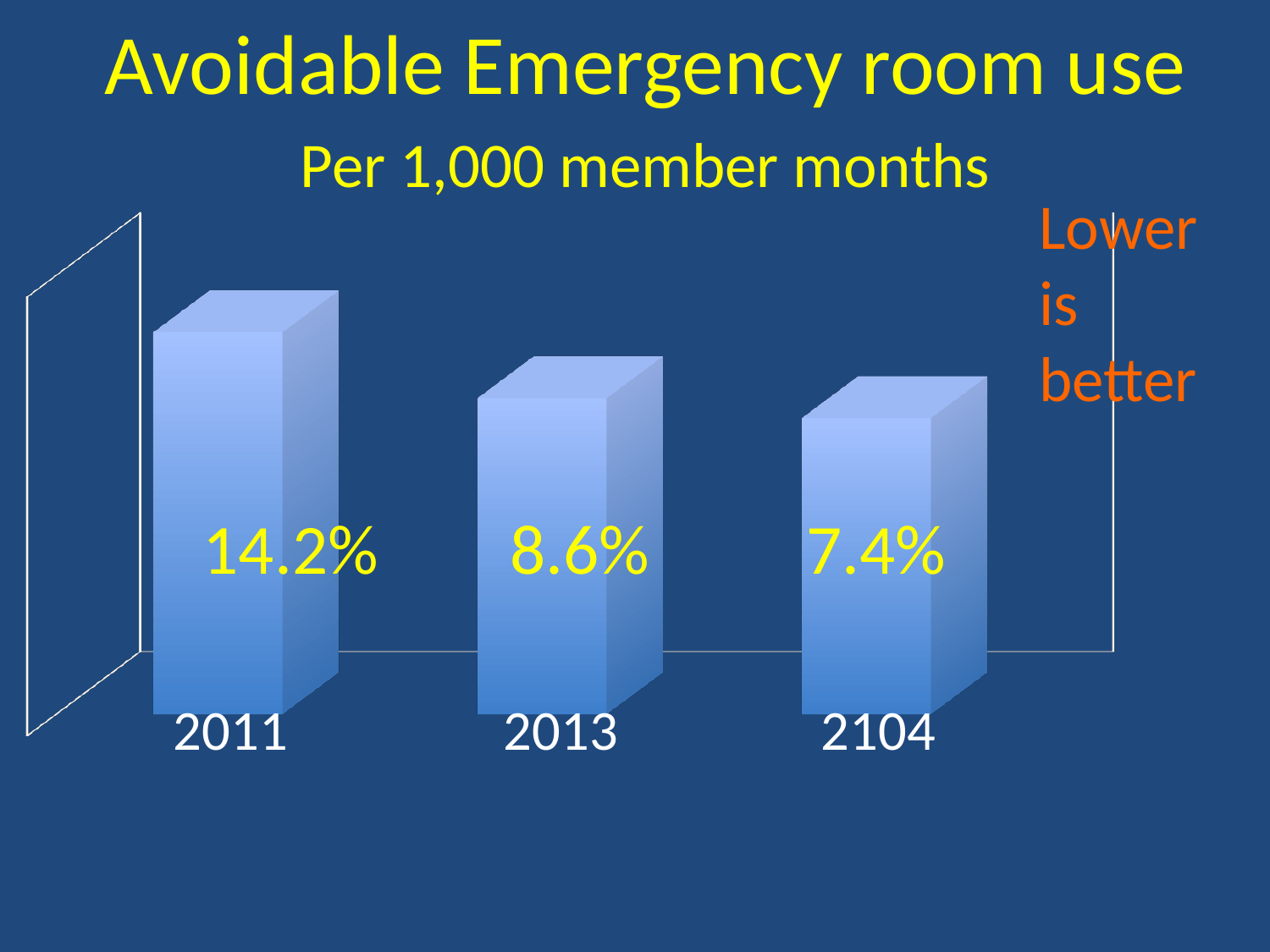
How many bars are shown in the chart? 3 What kind of chart is shown on the slide? bar chart Which is larger, the value for 2011 or the value for 2104? 2011 What is the title of the chart? Avoidable Emergency room use Per 1,000 member months What is the value for the category labelled 2104? 7.4% What is the difference between the values for 2011 and 2013? 5.6% What is the value for 2011? 14.2% What is the value for 2013? 8.6% Which category has the lowest value? 2104 What is the difference between the values for 2013 and 2104? 1.2% Do the values rise or fall from left to right across the categories? fall Which category has the highest value? 2011